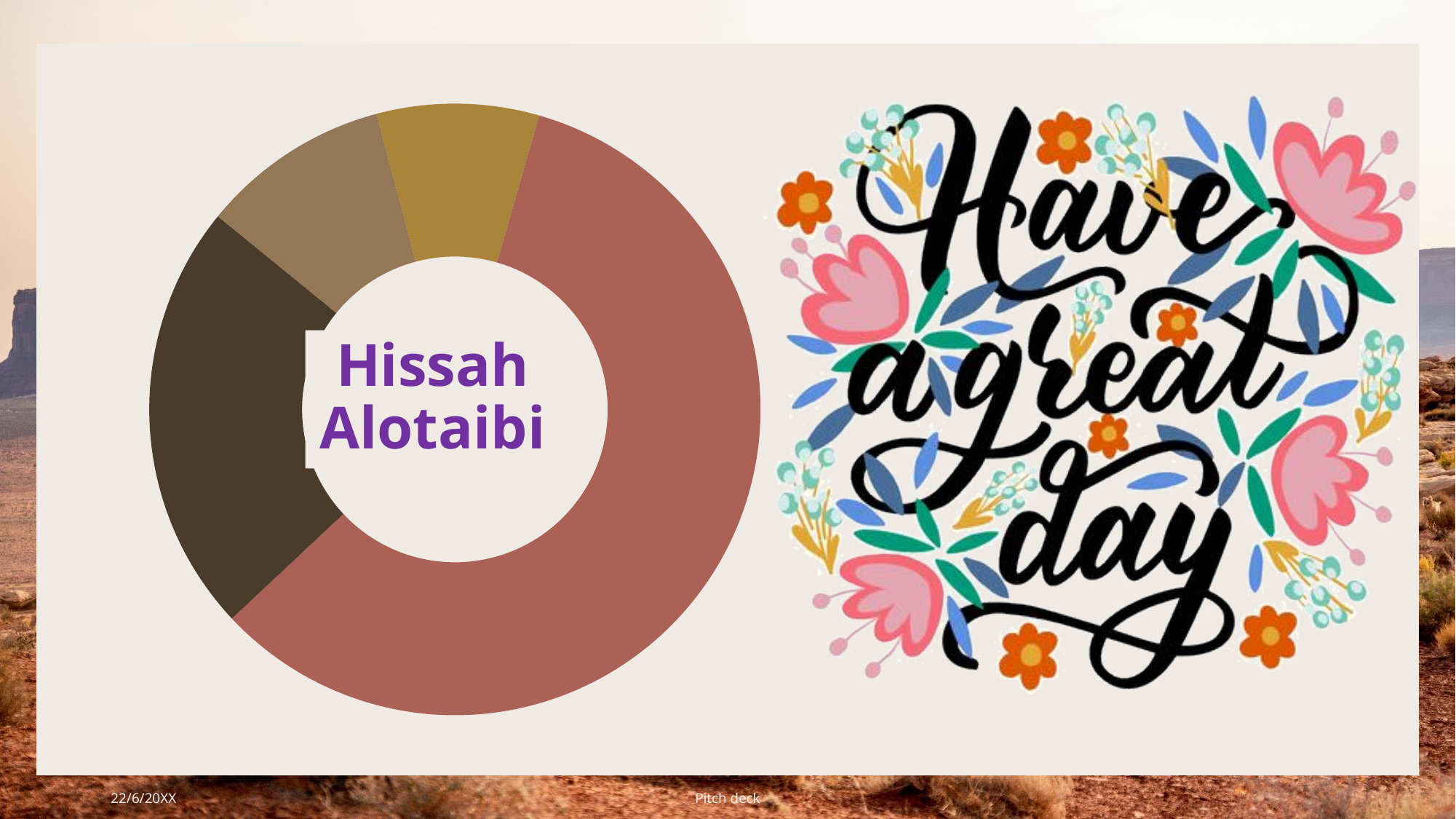
Does the doughnut chart display a legend? No What text appears in the centre of the doughnut chart? Hissah Alotaibi How many slices does the doughnut chart have? 4 Which slice is larger in the doughnut chart, the reddish-brown slice or the dark brown slice? The reddish-brown slice What kind of chart is shown on the left of the slide? Doughnut (pie) chart Which colour slice is the largest in the doughnut chart? The reddish-brown slice Which slice is larger in the doughnut chart, the dark brown slice or the gold slice? The dark brown slice